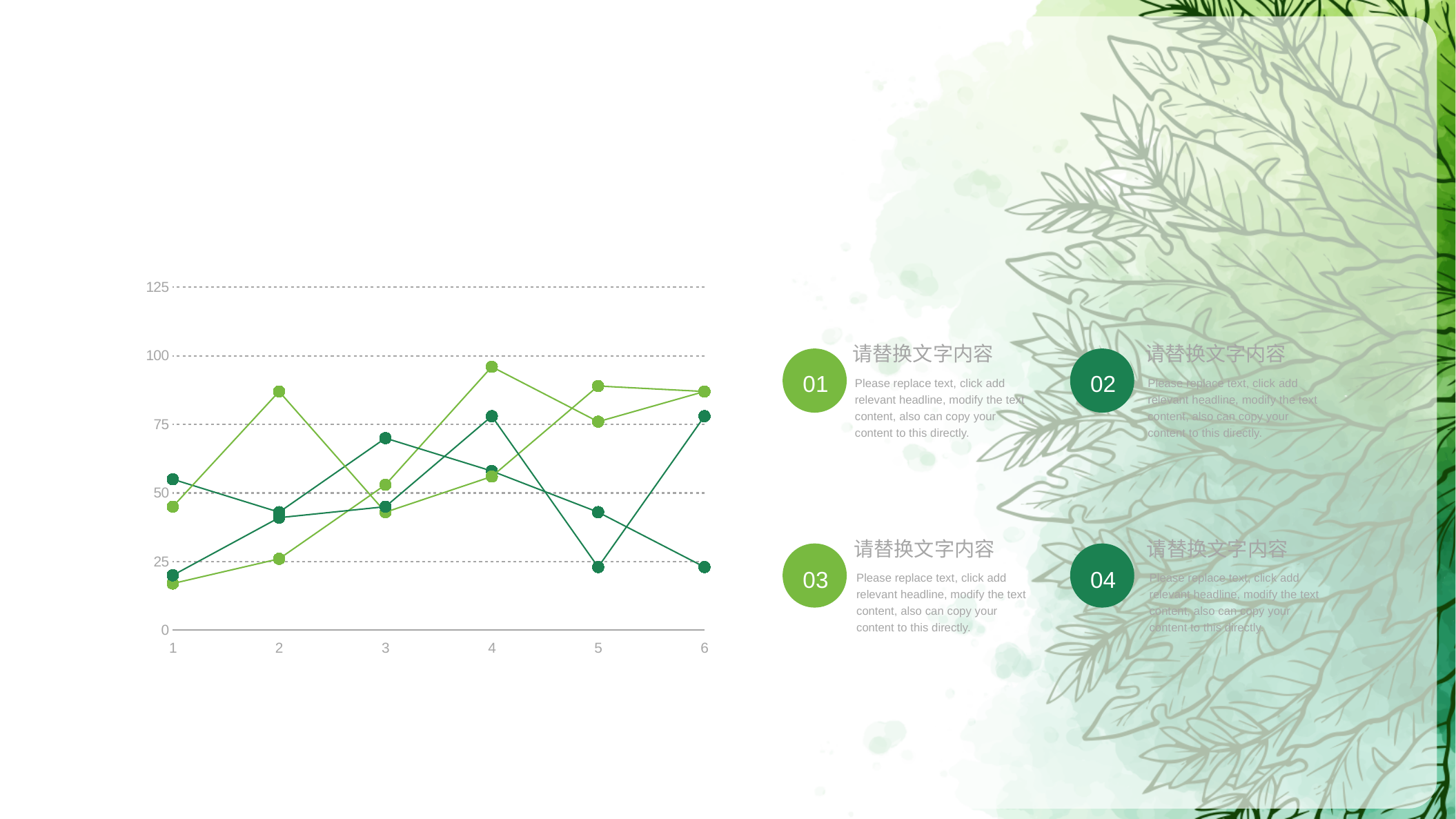
How many points are labelled along the x axis of the chart? 6 Is the lowest plotted value on the chart greater or less than 25? less Is the highest plotted value on the chart greater or less than 75? greater How many lines are plotted on the chart? 4 What is the highest value shown on the chart's y axis? 125 What kind of chart is shown on the slide? line chart What is the first label on the chart's x axis? 1 Is the highest plotted value on the chart greater or less than 100? less